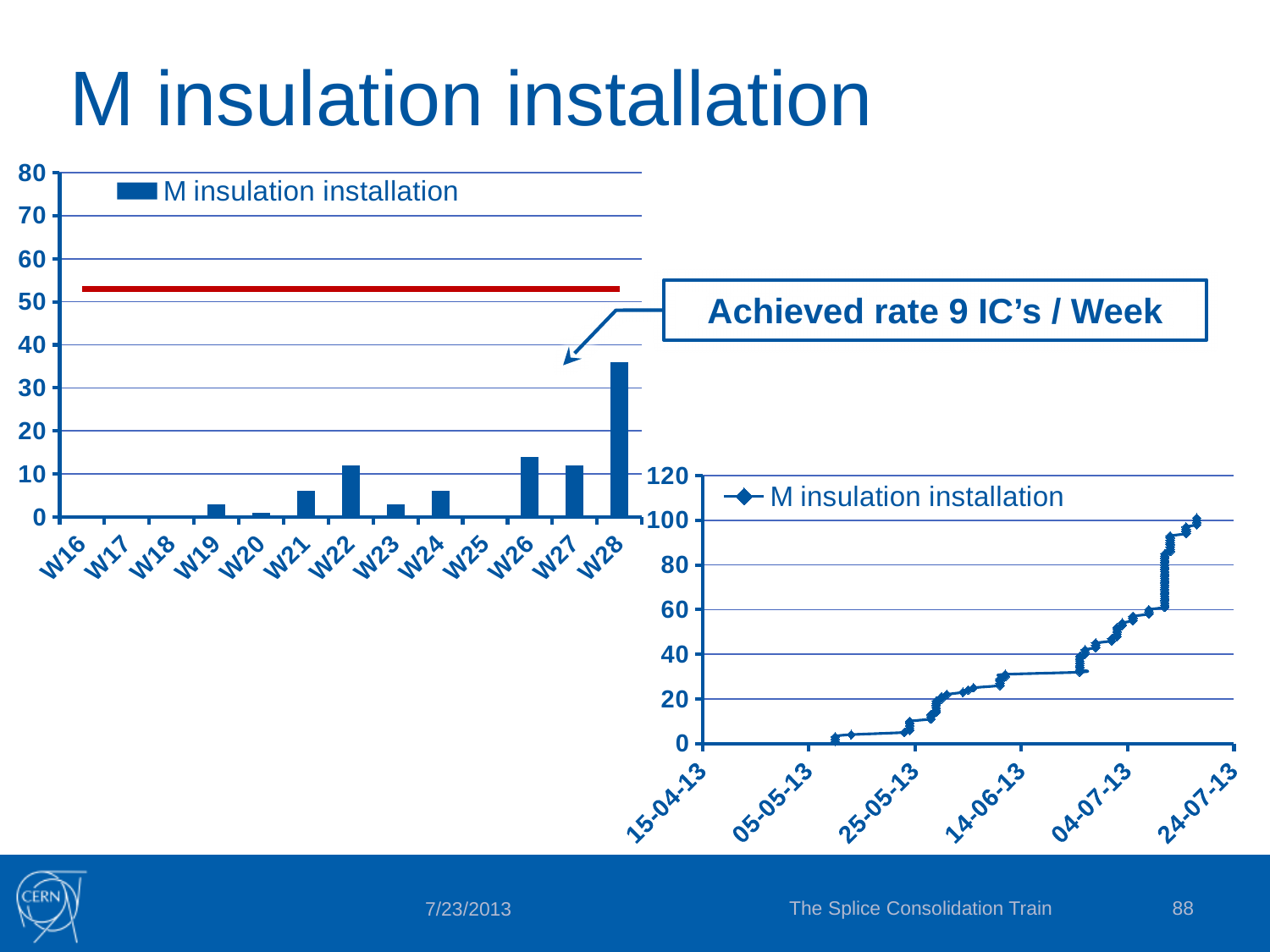
What kind of chart is the chart on the left of the slide? bar chart What kind of chart is the chart on the lower right of the slide? line chart In the bar chart on the left, is the value for W28 greater or less than 30? greater What does the text box on the slide say the achieved rate is? 9 IC's / Week In the line chart on the lower right, is the final plotted value greater or less than 80? greater In the bar chart on the left, how many weeks are shown on the x axis? 13 In the line chart on the lower right, do the values rise or fall along the x axis? rise In the bar chart on the left, which is larger, the value for W26 or the value for W23? W26 In the bar chart on the left, how many series does the legend list? 1 In the line chart on the lower right, how many date labels are shown on the x axis? 6 In the bar chart on the left, which week has the highest value? W28 In the bar chart on the left, is the value for W21 greater or less than 10? less